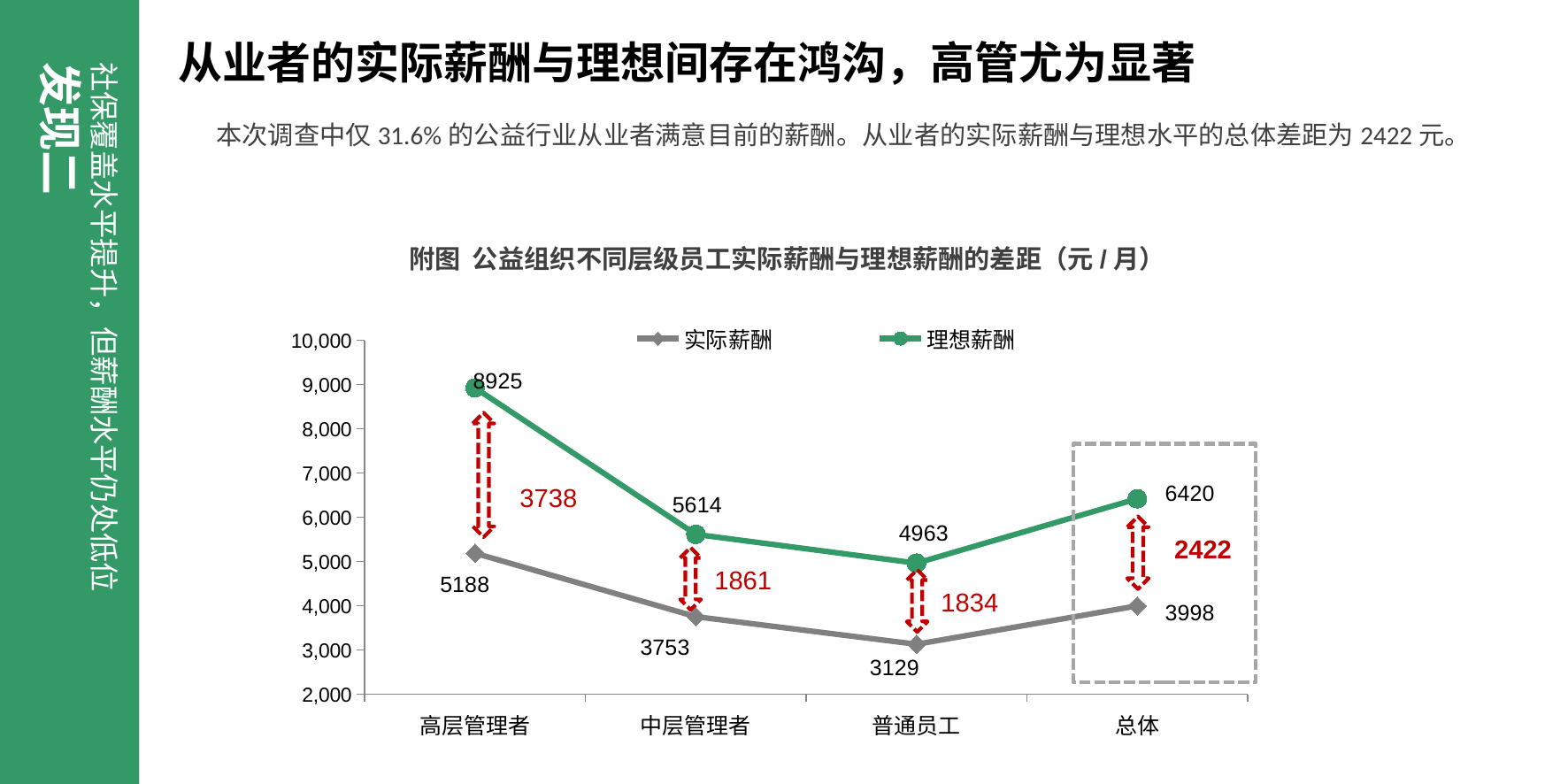
What is the 理想薪酬 value for 普通员工? 4963 Does the 实际薪酬 series rise or fall from 高层管理者 to 普通员工? fall What kind of chart is shown on the slide? line chart What is the 实际薪酬 value for 高层管理者? 5188 What is the 理想薪酬 value for 总体? 6420 How many series does the legend list? 2 Which category has the lowest 实际薪酬 value? 普通员工 What is the difference between 理想薪酬 and 实际薪酬 for 中层管理者? 1861 Which category has the highest 理想薪酬 value? 高层管理者 Which is larger, the 实际薪酬 for 高层管理者 or the 理想薪酬 for 普通员工? 实际薪酬 for 高层管理者 What colour is the 理想薪酬 line? green How many categories are shown on the x axis? 4